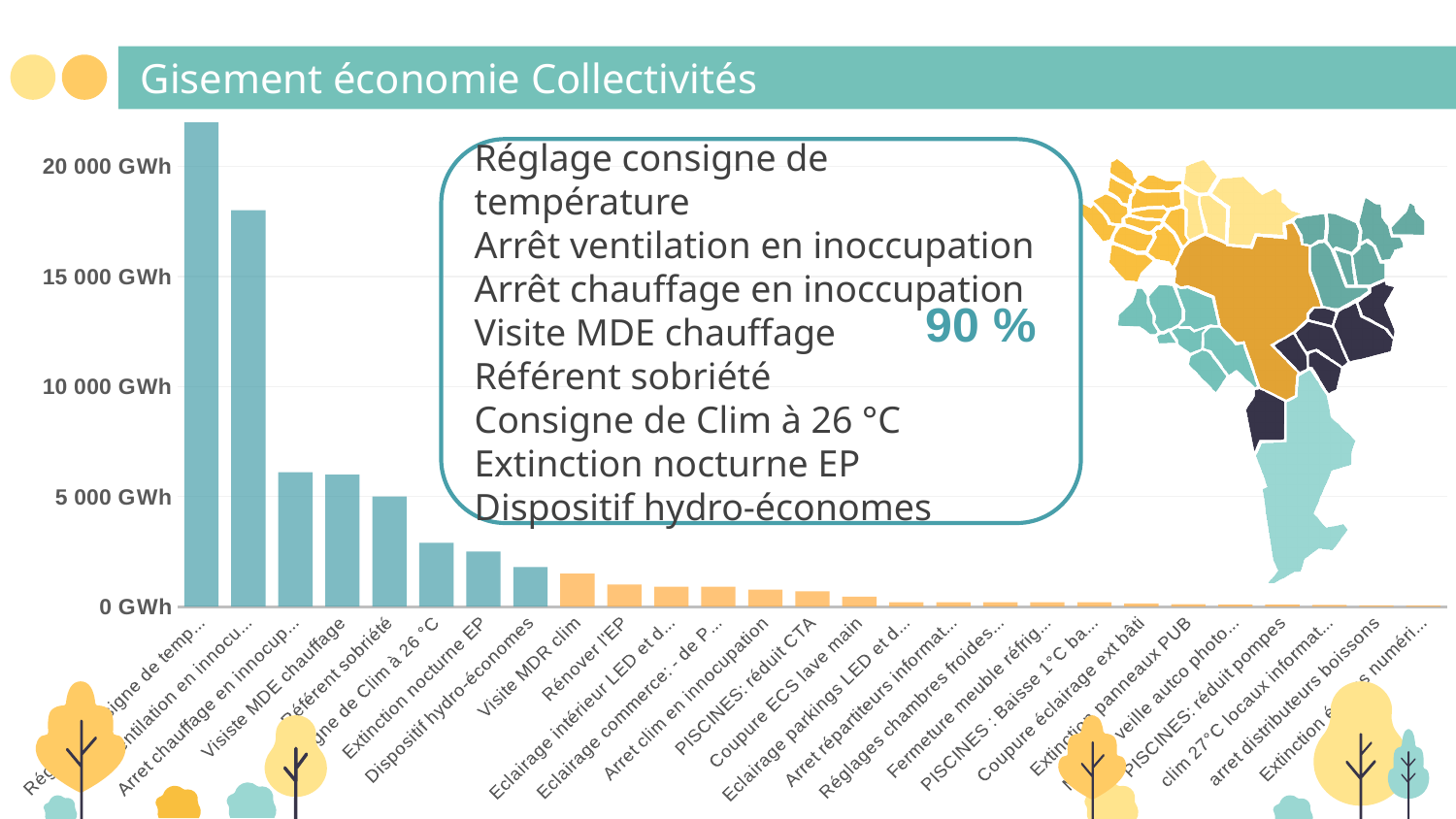
Which category has the highest value in the chart? Réglage consigne de température What percentage is printed in the text box overlaid on the chart? 90 % What kind of chart is shown on the slide? bar chart Do the bar values rise or fall from left to right along the x axis? fall Is the value for 'Visiste MDE chauffage' greater or less than 5 000 GWh? greater Is the value for 'Arrêt ventilation en inoccupation' greater or less than 15 000 GWh? greater What is the title of the slide containing the chart? Gisement économie Collectivités Which is larger, the value for 'Arrêt ventilation en inoccupation' or the value for 'Référent sobriété'? Arrêt ventilation en inoccupation Which is larger, the value for 'Visiste MDE chauffage' or the value for 'Extinction nocturne EP'? Visiste MDE chauffage Is the value for 'Visite MDR clim' greater or less than 5 000 GWh? less